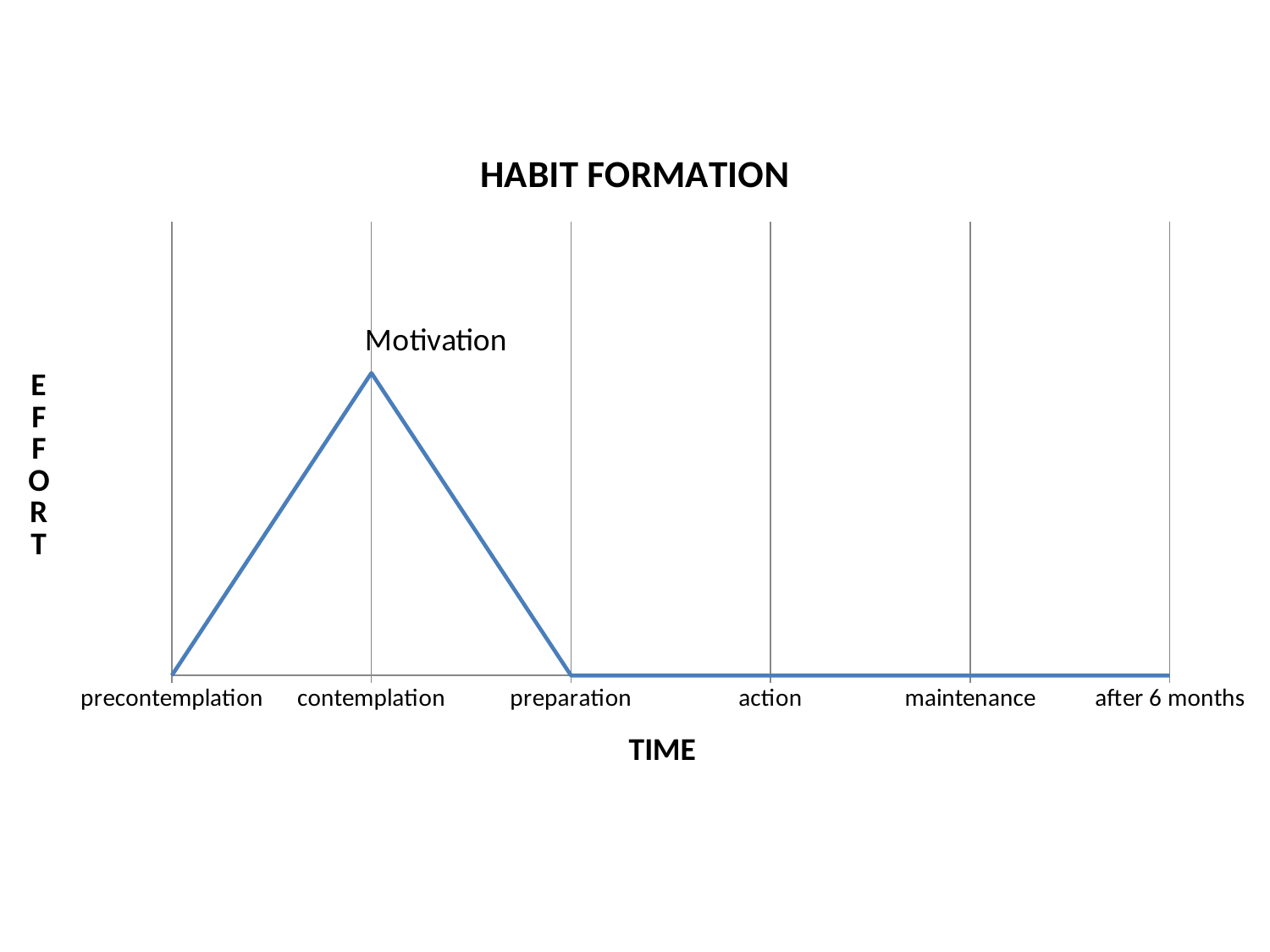
Which category is the first one on the x axis? precontemplation Does the line rise or fall between precontemplation and contemplation? rise Which category is the last one on the x axis? after 6 months How many categories are shown on the x axis? 6 At which category does the line reach its highest point? contemplation What kind of chart is shown on the slide? line chart Is the value at contemplation larger or smaller than the value at action? larger What is the label on the x axis? TIME What is the title of the chart? HABIT FORMATION Does the line rise, fall, or stay flat from preparation to after 6 months? stay flat Does the line rise or fall between contemplation and preparation? fall